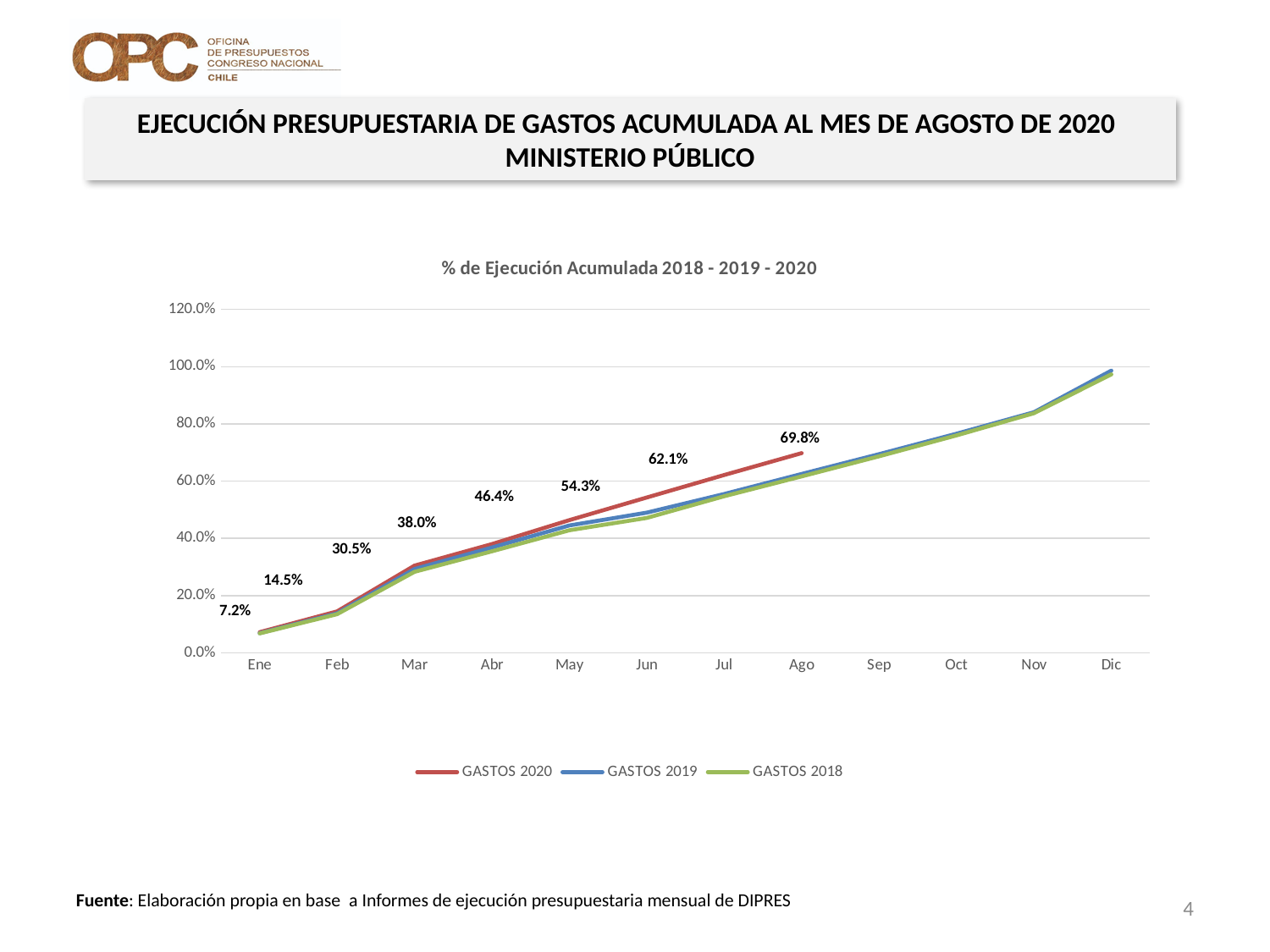
What is the difference between the GASTOS 2020 values for Ago and Jul? 7.7% Is the value for GASTOS 2019 in Dic greater or less than 80.0%? greater What is the value of GASTOS 2020 in Abr? 38.0% Which month has the highest labelled value for GASTOS 2020? Ago What is the difference between the GASTOS 2020 values for Mar and Feb? 16.0% What is the value of GASTOS 2020 in Jun? 54.3% What is the value of GASTOS 2020 in Ago? 69.8% How many months are shown on the x axis? 12 How many series does the legend list? 3 Do the GASTOS 2020 values rise or fall from Ene to Ago? rise What is the value of GASTOS 2020 in Ene? 7.2% What type of chart is shown on the slide? line chart